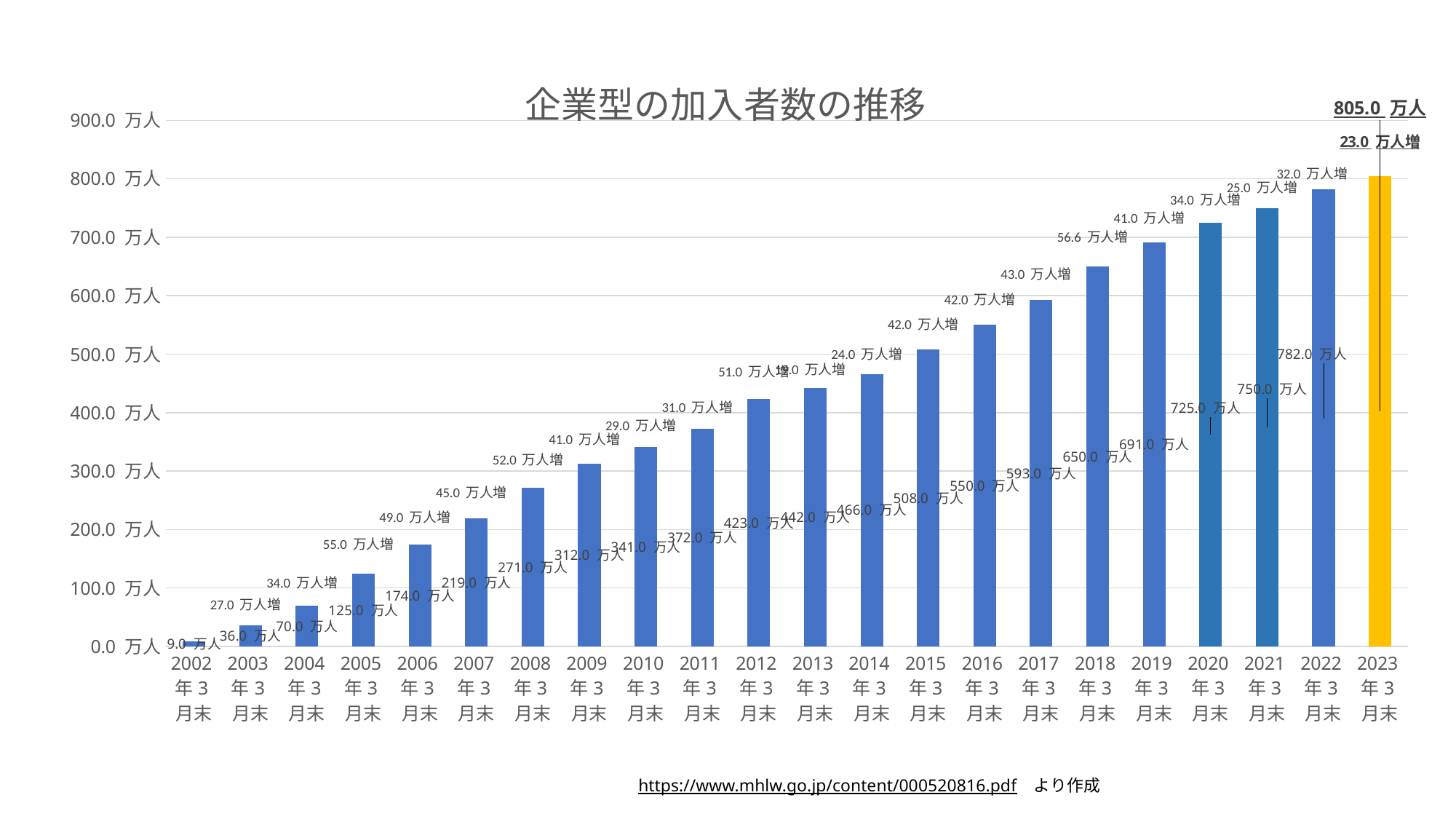
What kind of chart is shown on the slide? bar chart Which year has the highest value? 2023年3月末 What is the value for 2012年3月末? 423.0 万人 What is the title of the chart? 企業型の加入者数の推移 What increase is labeled above the 2018年3月末 bar? 56.6 万人増 Which year has the lowest value? 2002年3月末 Which is larger, the value for 2015年3月末 or 2016年3月末? 2016年3月末 What is the difference between the values for 2022年3月末 and 2023年3月末? 23.0 万人 What is the value for 2023年3月末? 805.0 万人 How many bars (years) are plotted in the chart? 22 Do the values rise or fall from 2002 to 2023? rise What is the value for 2002年3月末? 9.0 万人